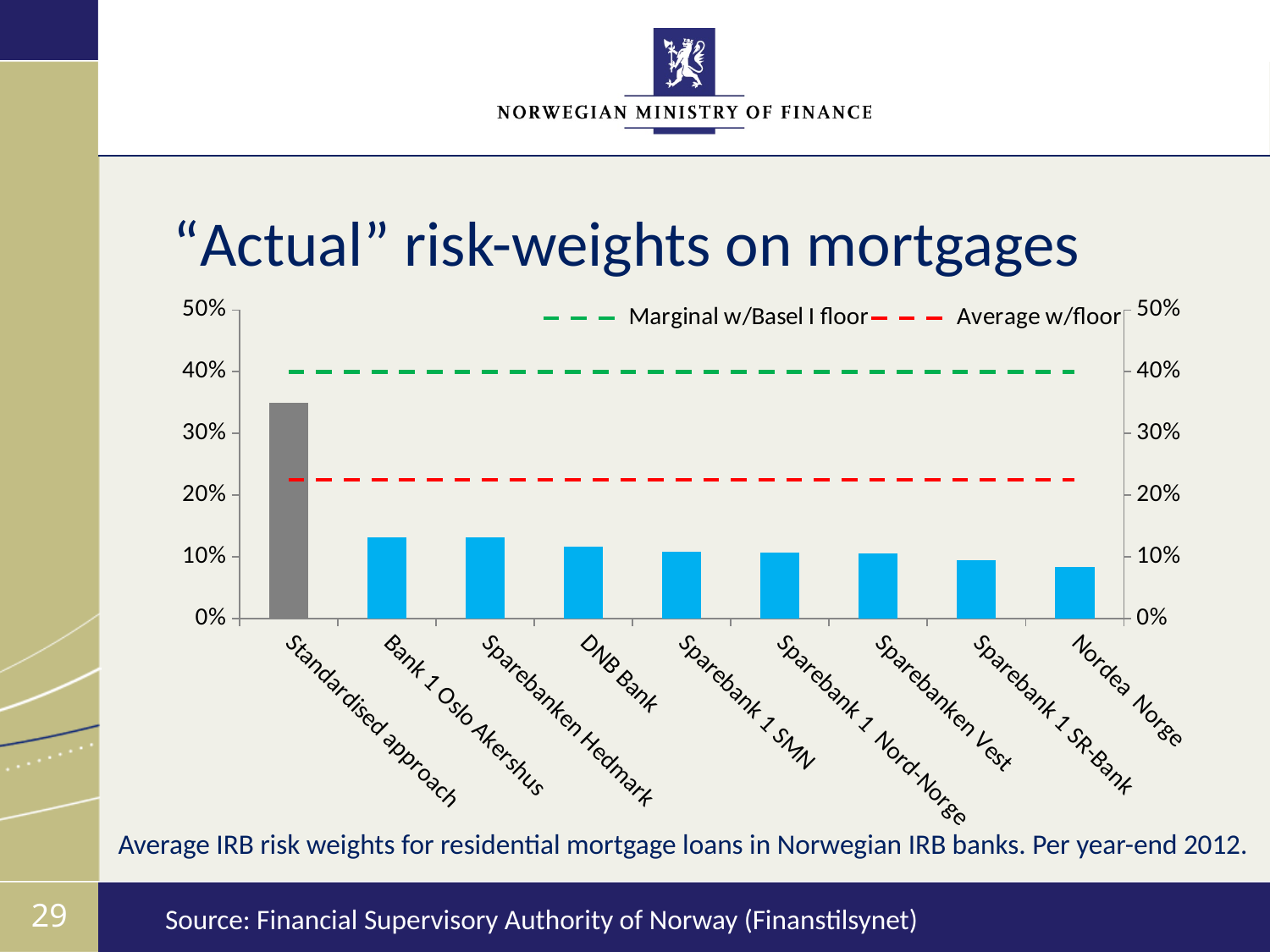
What is the title of the chart? "Actual" risk-weights on mortgages Do the bar values generally rise or fall from left to right along the x axis? fall What kind of chart is shown on the slide? combination bar and line chart Which bank has the lowest bar? Nordea Norge How many categories are shown on the x axis? 9 Is the value for Nordea Norge greater or less than 10%? less Which category has the highest bar? Standardised approach How many entries does the legend list? 2 Is the value for Standardised approach greater or less than 30%? greater Which is larger, the value for Standardised approach or the value for DNB Bank? Standardised approach Is the value for Bank 1 Oslo Akershus greater or less than 10%? greater